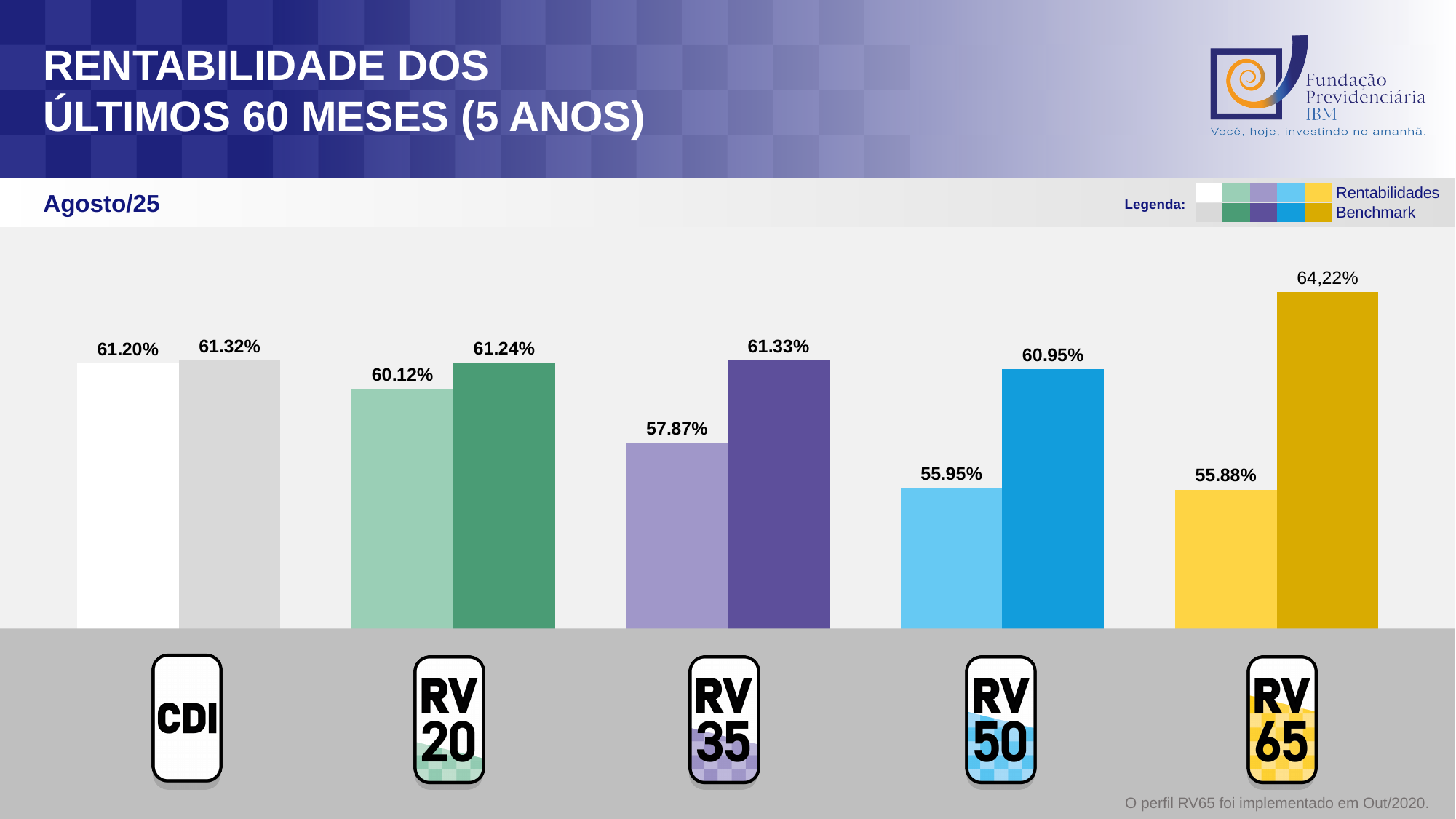
Which category has the highest Rentabilidades value? CDI What is the difference between the Benchmark and Rentabilidades values for RV35? 3.46% What is the difference between the Benchmark and Rentabilidades values for RV50? 5.00% Which is larger, the Rentabilidades value for RV20 or the Rentabilidades value for RV35? RV20 What kind of chart is shown on the slide? Bar chart Which category has the highest Benchmark value? RV65 How many series does the legend list? 2 What is the Benchmark value for RV65? 64,22% What is the Rentabilidades value for RV35? 57.87% What is the Benchmark value for RV50? 60.95% What is the Rentabilidades value for CDI? 61.20% How many categories are shown on the x axis of the chart? 5